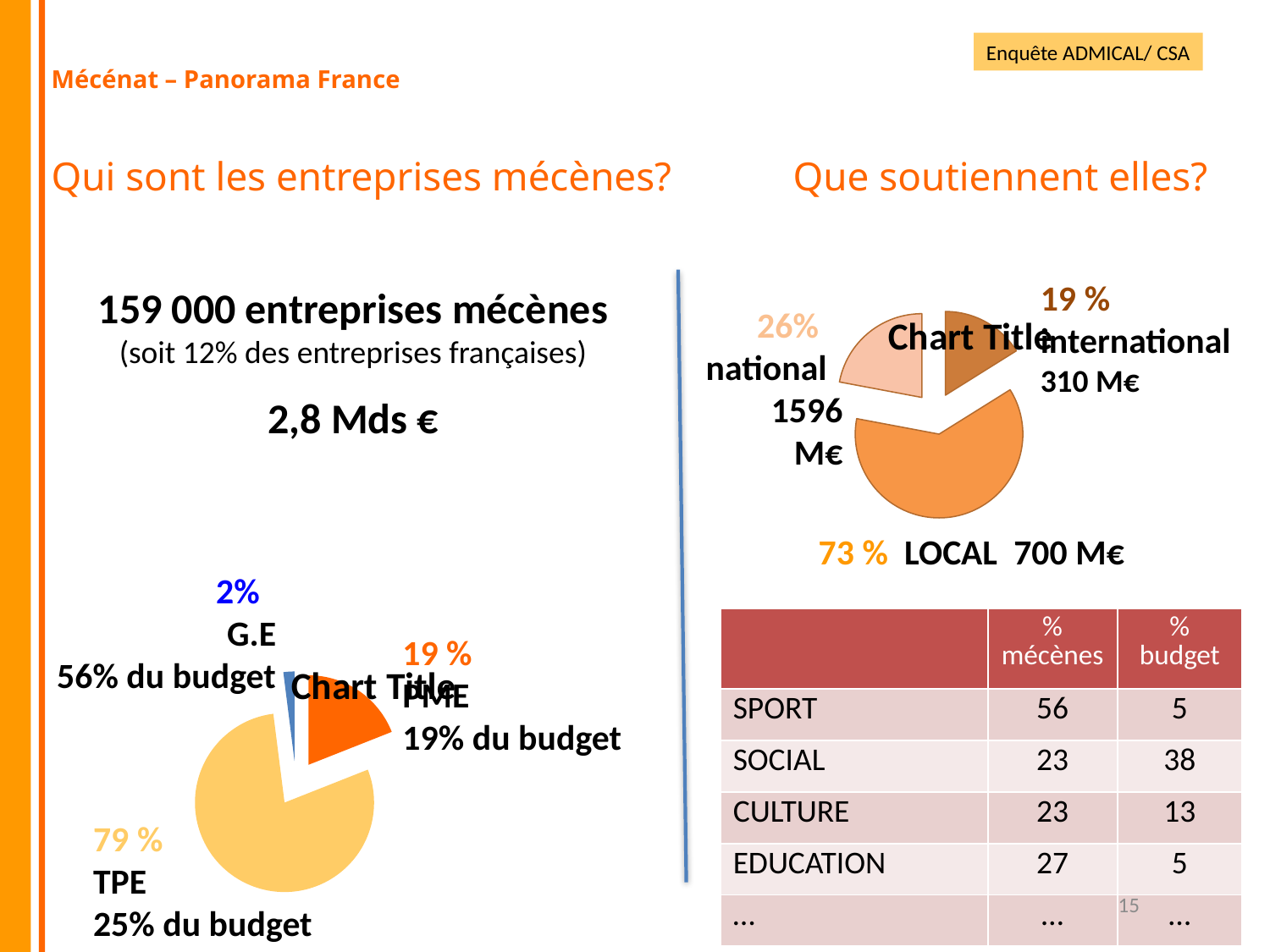
In the pie chart at the bottom left, how many slices are there? 3 In the pie chart at the bottom left, what share is labelled for TPE? 79 % What kind of chart is the chart at the bottom left of the slide? pie chart In the pie chart at the top right, what is the difference between the amounts labelled for national and international? 1286 M€ In the pie chart at the bottom left, what share is labelled for PME? 19 % In the pie chart at the top right, which category has the largest slice? LOCAL In the pie chart at the bottom left, which category has the largest slice? TPE In the pie chart at the top right, what percentage is labelled for international? 19 % In the pie chart at the bottom left, what share of the budget is labelled for G.E? 56% du budget In the pie chart at the top right, what amount is labelled for LOCAL? 700 M€ In the pie chart at the top right, what amount is labelled for national? 1596 M€ In the pie chart at the bottom left, which category has the smallest slice? G.E